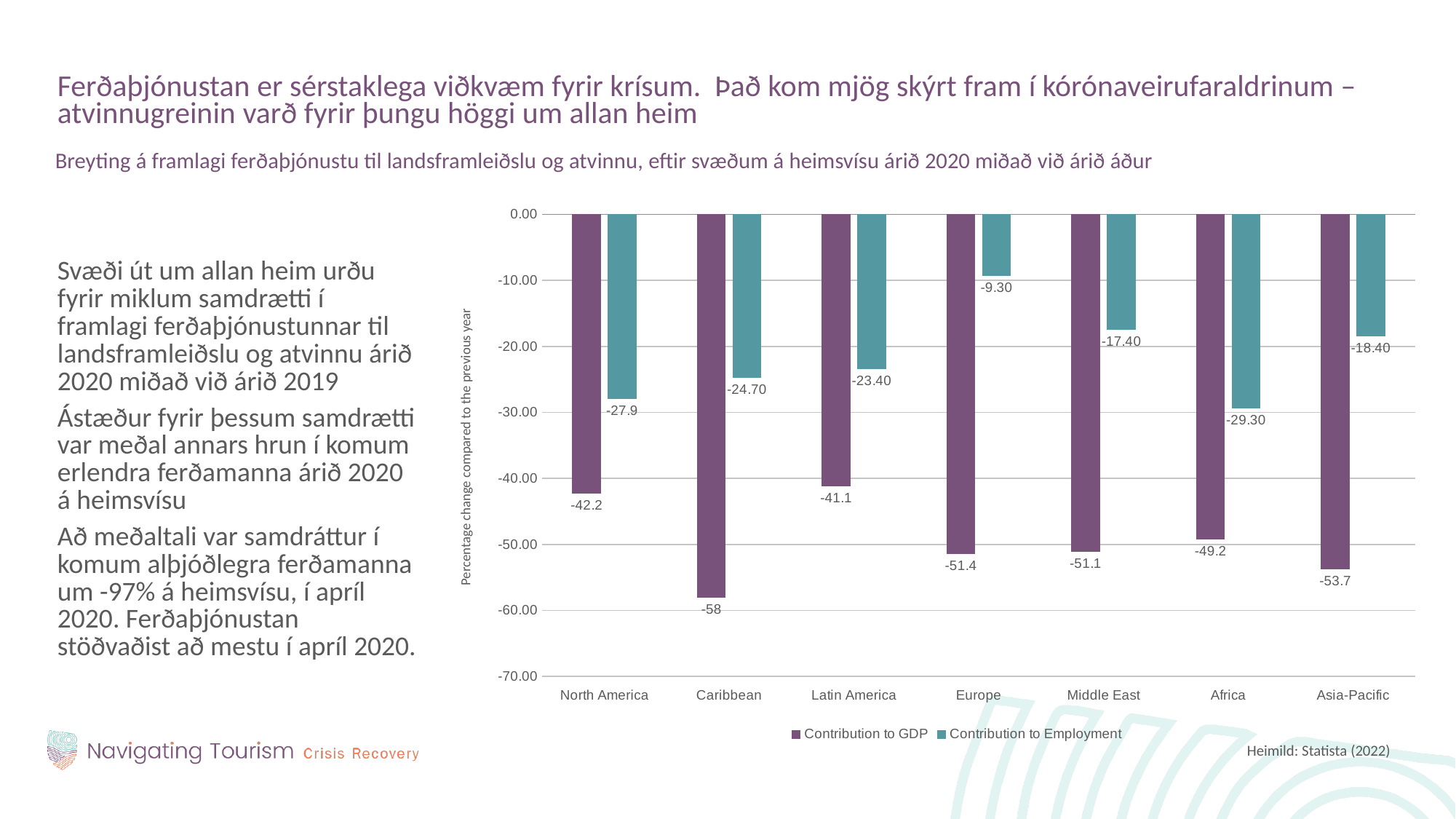
How many series does the legend list? 2 Which region has the highest (least negative) Contribution to Employment value? Europe What is the Contribution to GDP value for Caribbean? -58 What kind of chart is shown on the slide? Bar chart What is the Contribution to GDP value for Asia-Pacific? -53.7 How many regions are shown on the x axis? 7 What is the Contribution to Employment value for Europe? -9.30 Which region has the lowest Contribution to GDP value? Caribbean What is the Contribution to Employment value for Middle East? -17.40 Which is higher, the Contribution to Employment value for Europe or for Asia-Pacific? Europe Which region has the lowest Contribution to Employment value? Africa What is the difference between the Contribution to GDP and Contribution to Employment values for Europe? 42.1